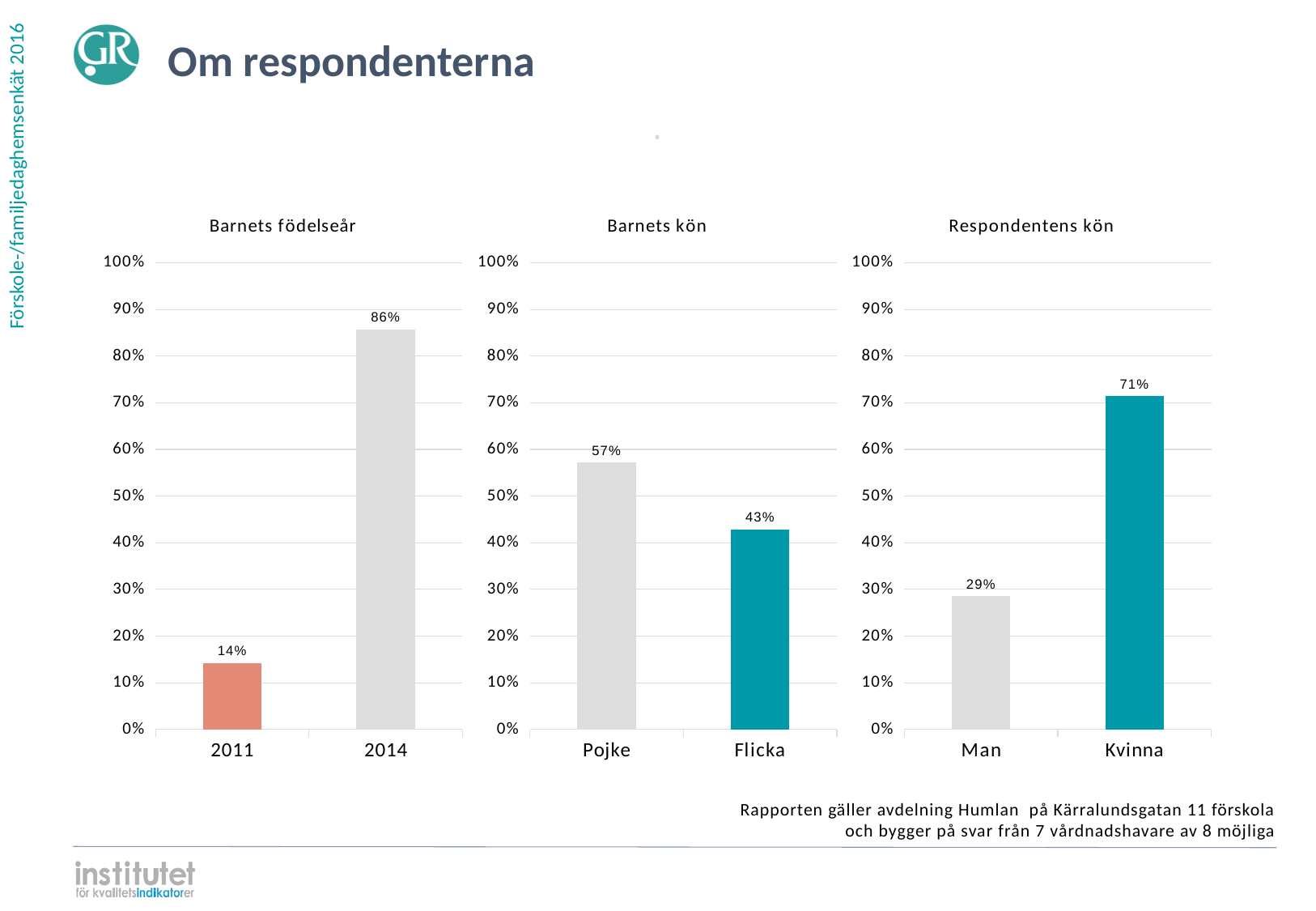
In the 'Barnets kön' chart, which is larger, Pojke or Flicka? Pojke How many categories are shown in the 'Barnets kön' chart? 2 In the 'Barnets födelseår' chart, what is the value for 2014? 86% In the 'Respondentens kön' chart, what is the value for Kvinna? 71% What kind of chart is the 'Respondentens kön' chart? Bar chart What is the title of the chart on the left of the slide? Barnets födelseår In the 'Respondentens kön' chart, what is the difference between Kvinna and Man? 42% In the 'Barnets kön' chart, what is the value for Pojke? 57% In the 'Barnets födelseår' chart, what is the value for 2011? 14% In the 'Barnets födelseår' chart, what is the difference between the values for 2014 and 2011? 72% In the 'Respondentens kön' chart, which category has the lowest value? Man In the 'Barnets kön' chart, what is the value for Flicka? 43%